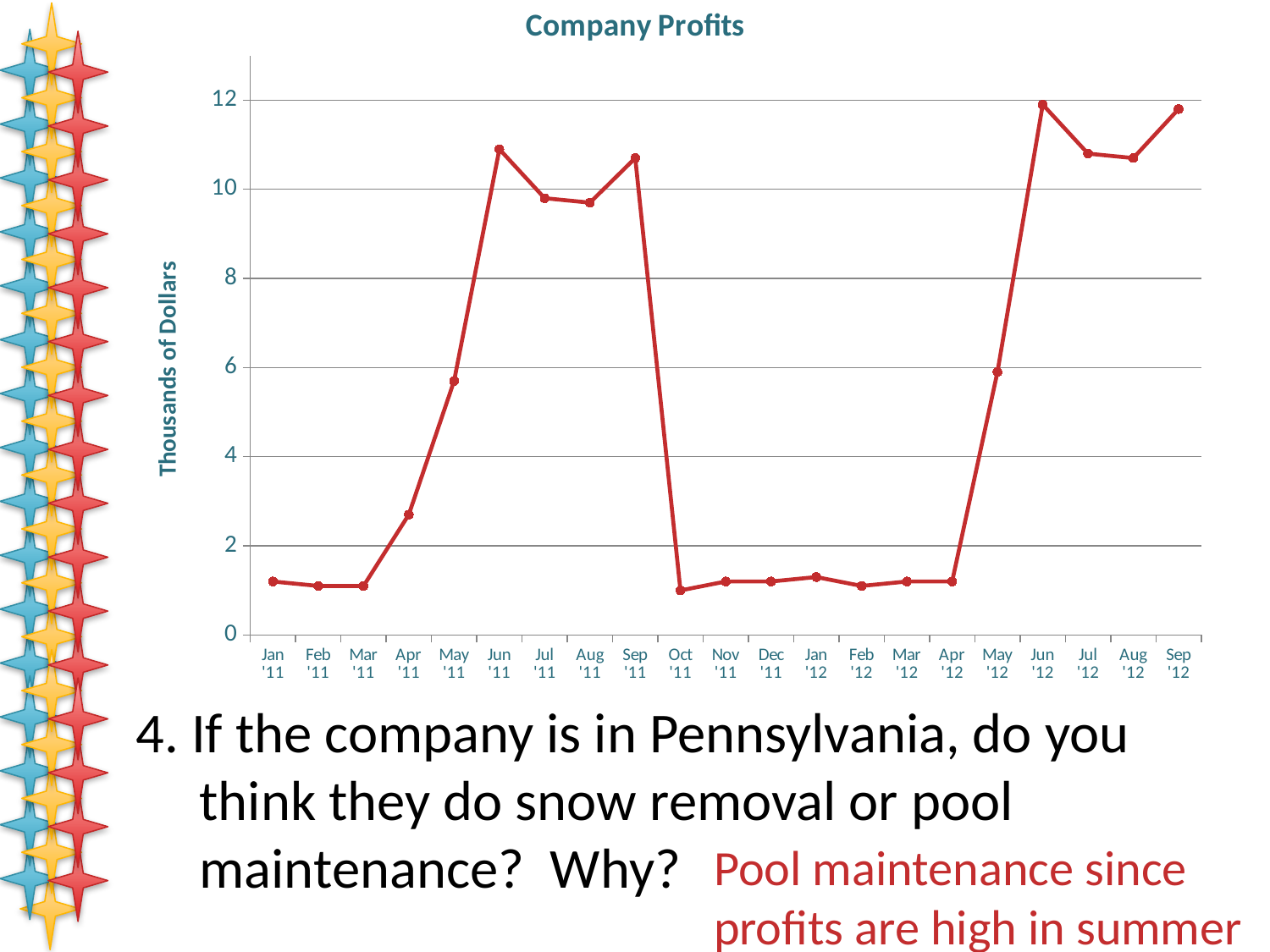
Do the values rise or fall from Sep '11 to Oct '11? fall Is the value for Jun '11 greater or less than 10? greater Do the values rise or fall from Jan '11 to Jun '11? rise Is the value for Oct '11 greater or less than 2? less Which is larger, the value for Jun '11 or the value for Jan '11? Jun '11 What is the title of the chart? Company Profits What kind of chart is shown on the slide? line chart How many months are plotted along the x axis of the chart? 21 Is the value for Jun '12 greater or less than 10? greater What is the label on the vertical axis of the chart? Thousands of Dollars